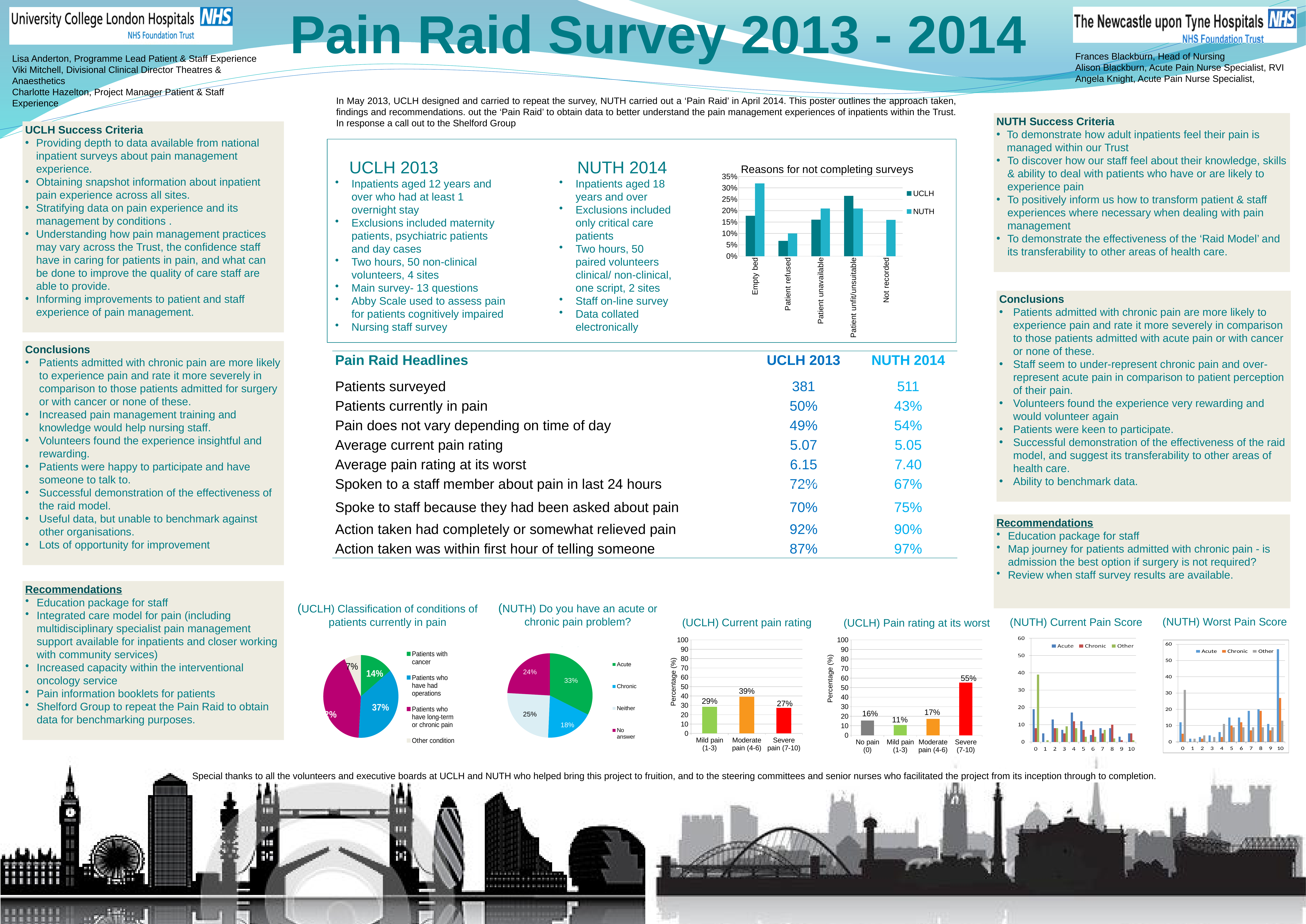
In the 'Reasons for not completing surveys' chart, how many series does the legend list? 2 In the '(UCLH) Pain rating at its worst' chart, what is the value for Severe (7-10)? 55% In the '(NUTH) Do you have an acute or chronic pain problem?' pie chart, which slice is the smallest? Chronic In the '(UCLH) Pain rating at its worst' chart, what is the difference between Severe (7-10) and Moderate pain (4-6)? 38% In the '(UCLH) Current pain rating' chart, which category has the lowest value? Severe pain (7-10) In the '(UCLH) Pain rating at its worst' chart, how many categories are shown on the x axis? 4 In the '(NUTH) Do you have an acute or chronic pain problem?' pie chart, what share is Acute? 33% In the '(UCLH) Current pain rating' chart, what is the value for Moderate pain (4-6)? 39% What kind of chart is the '(NUTH) Current Pain Score' chart? Bar chart In the '(UCLH) Classification of conditions of patients currently in pain' pie chart, what share is 'Patients with cancer'? 14% In the 'Reasons for not completing surveys' chart, is the NUTH value for Empty bed greater or less than 30%? greater In the 'Reasons for not completing surveys' chart, which is larger for Patient unfit/unsuitable, UCLH or NUTH? UCLH